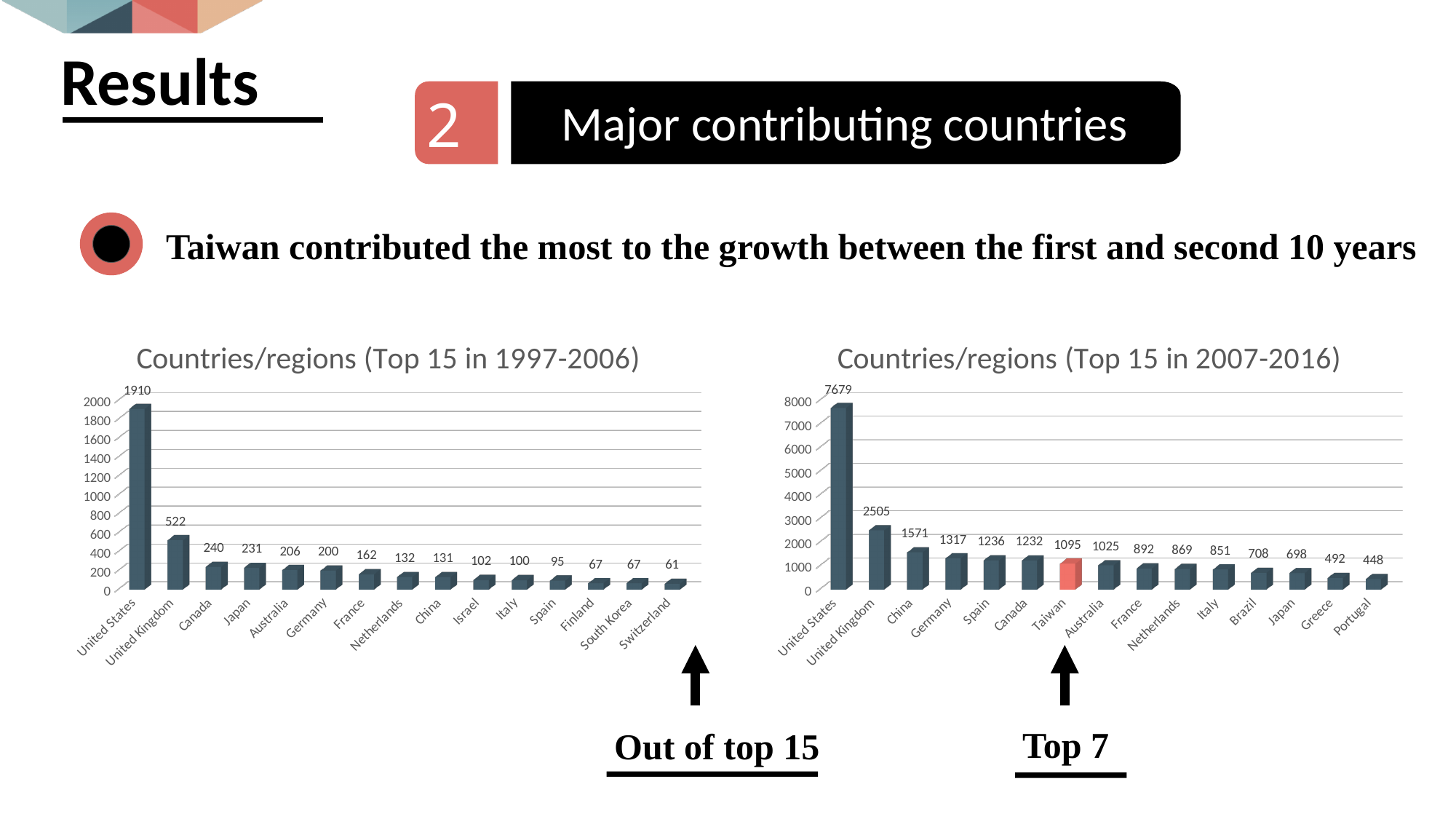
In the chart titled 'Countries/regions (Top 15 in 2007-2016)', do the values rise or fall from left to right along the x axis? Fall In the chart titled 'Countries/regions (Top 15 in 2007-2016)', what is the value for Taiwan? 1095 In the chart titled 'Countries/regions (Top 15 in 2007-2016)', what is the value for Portugal? 448 In the chart titled 'Countries/regions (Top 15 in 1997-2006)', what is the difference between the values for the United States and the United Kingdom? 1388 In the chart titled 'Countries/regions (Top 15 in 1997-2006)', how many countries/regions are shown? 15 In the chart titled 'Countries/regions (Top 15 in 1997-2006)', what is the value for the United States? 1910 In the chart titled 'Countries/regions (Top 15 in 2007-2016)', which country has the highest value? United States In the chart titled 'Countries/regions (Top 15 in 1997-2006)', which country has the lowest value? Switzerland What kind of chart is the chart titled 'Countries/regions (Top 15 in 2007-2016)'? Bar chart In the chart titled 'Countries/regions (Top 15 in 1997-2006)', which is larger, the value for Canada or the value for Japan? Canada In the chart titled 'Countries/regions (Top 15 in 2007-2016)', what is the difference between the values for the United Kingdom and China? 934 In the chart titled 'Countries/regions (Top 15 in 2007-2016)', which bar is highlighted in a different colour (red) from the others? Taiwan